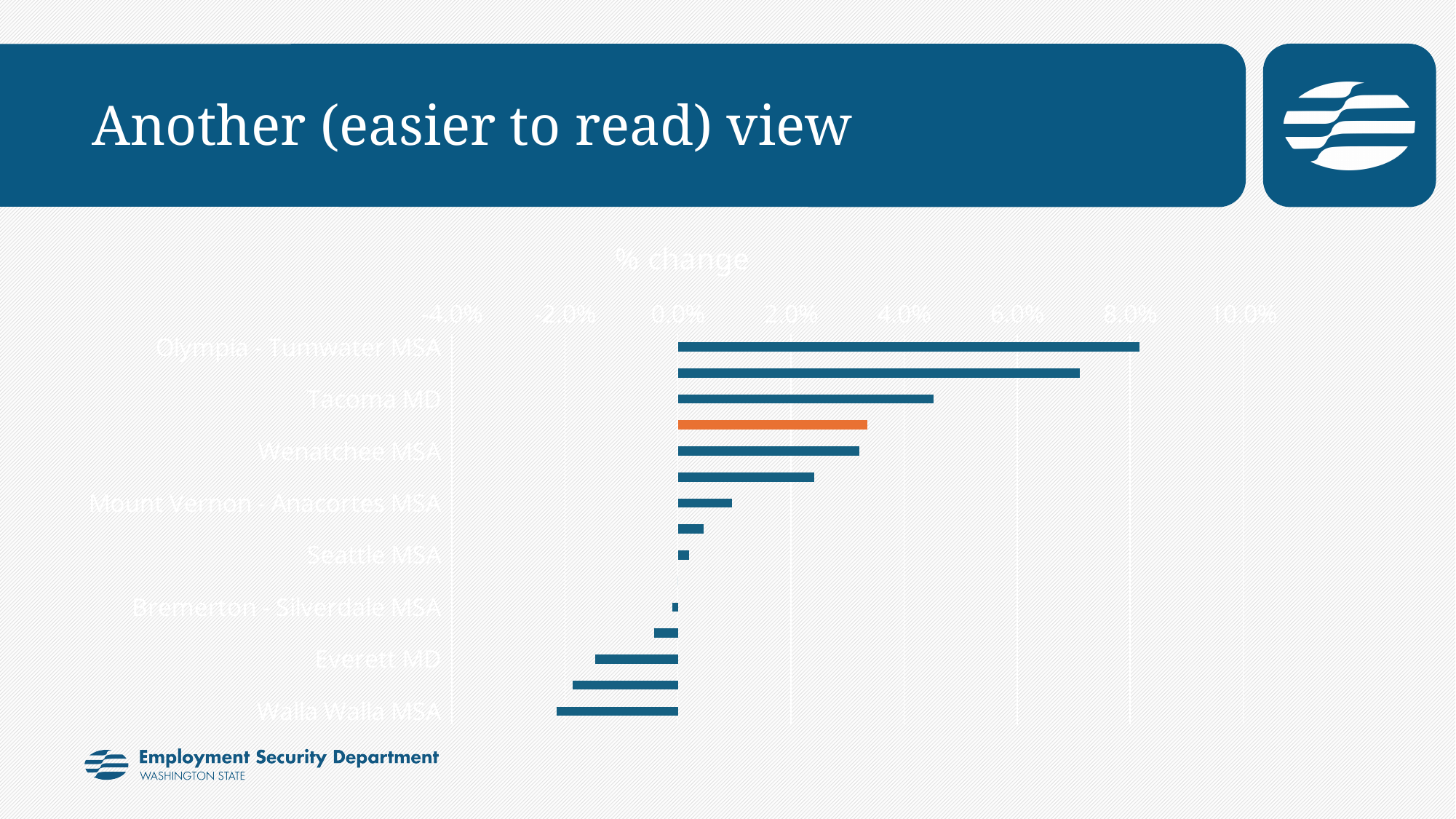
Is the value for Walla Walla MSA greater or less than 0.0%? less Which has the larger % change, Seattle MSA or Walla Walla MSA? Seattle MSA What colour is the single highlighted bar that differs from the others? orange Which labelled area has the lowest % change? Walla Walla MSA Is the value for Tacoma MD greater or less than 2.0%? greater Is the value for Mount Vernon - Anacortes MSA greater or less than 2.0%? less What is the title shown above the chart? % change Which has the larger % change, Tacoma MD or Wenatchee MSA? Tacoma MD Which labelled area has the highest % change? Olympia - Tumwater MSA What kind of chart is shown on the slide? bar chart